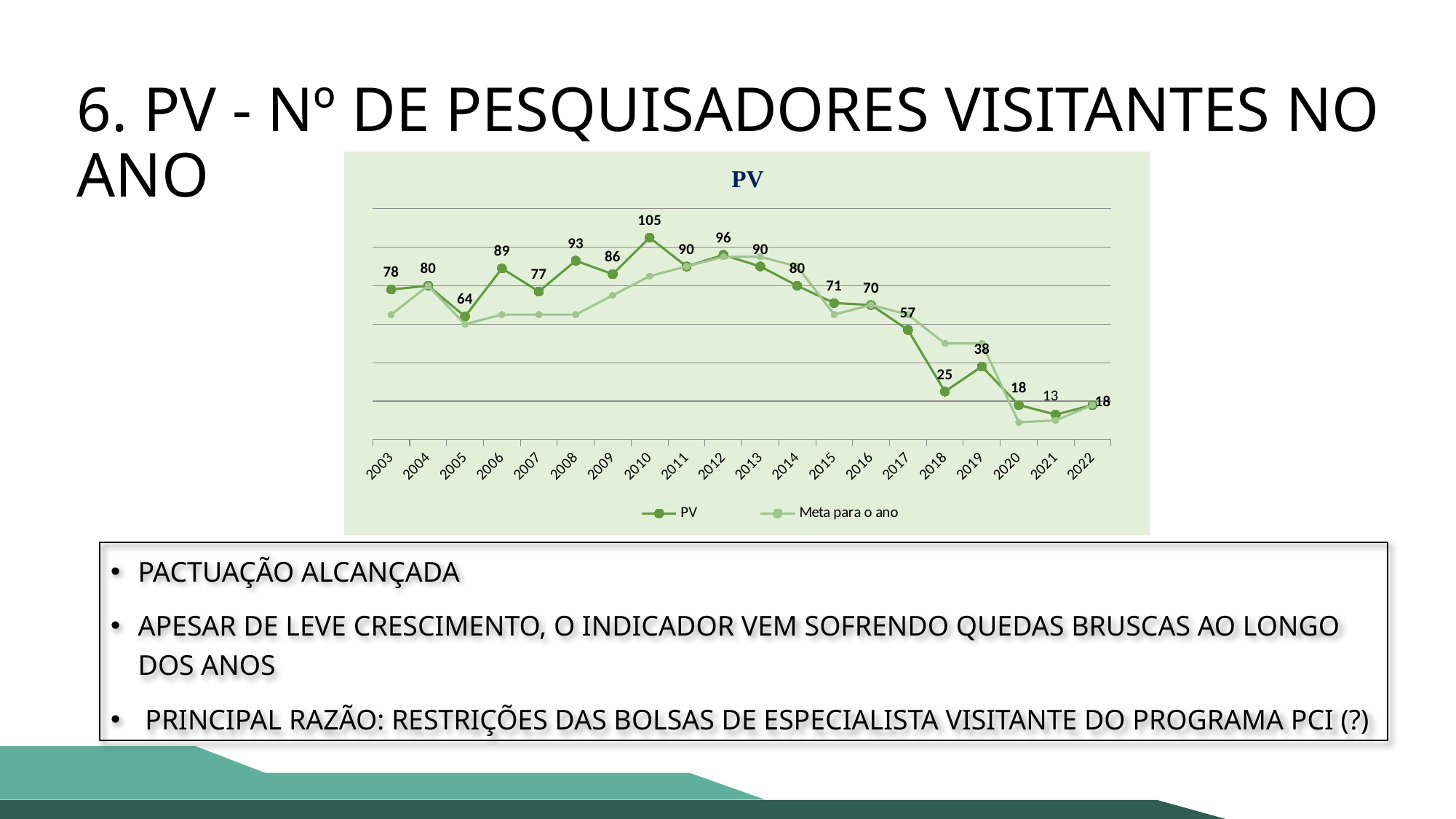
How many series does the legend list? 2 What is the difference between the PV values for 2017 and 2018? 32 How many years are shown on the x axis? 20 In which year is the PV series lowest? 2021 What is the title of the chart? PV Which year has a larger PV value, 2012 or 2013? 2012 Does the PV series generally rise or fall from 2012 to 2021? fall In which year is the PV series highest? 2010 What is the PV value for 2010? 105 What is the PV value for 2021? 13 What is the PV value for 2005? 64 What type of chart is shown on the slide? line chart